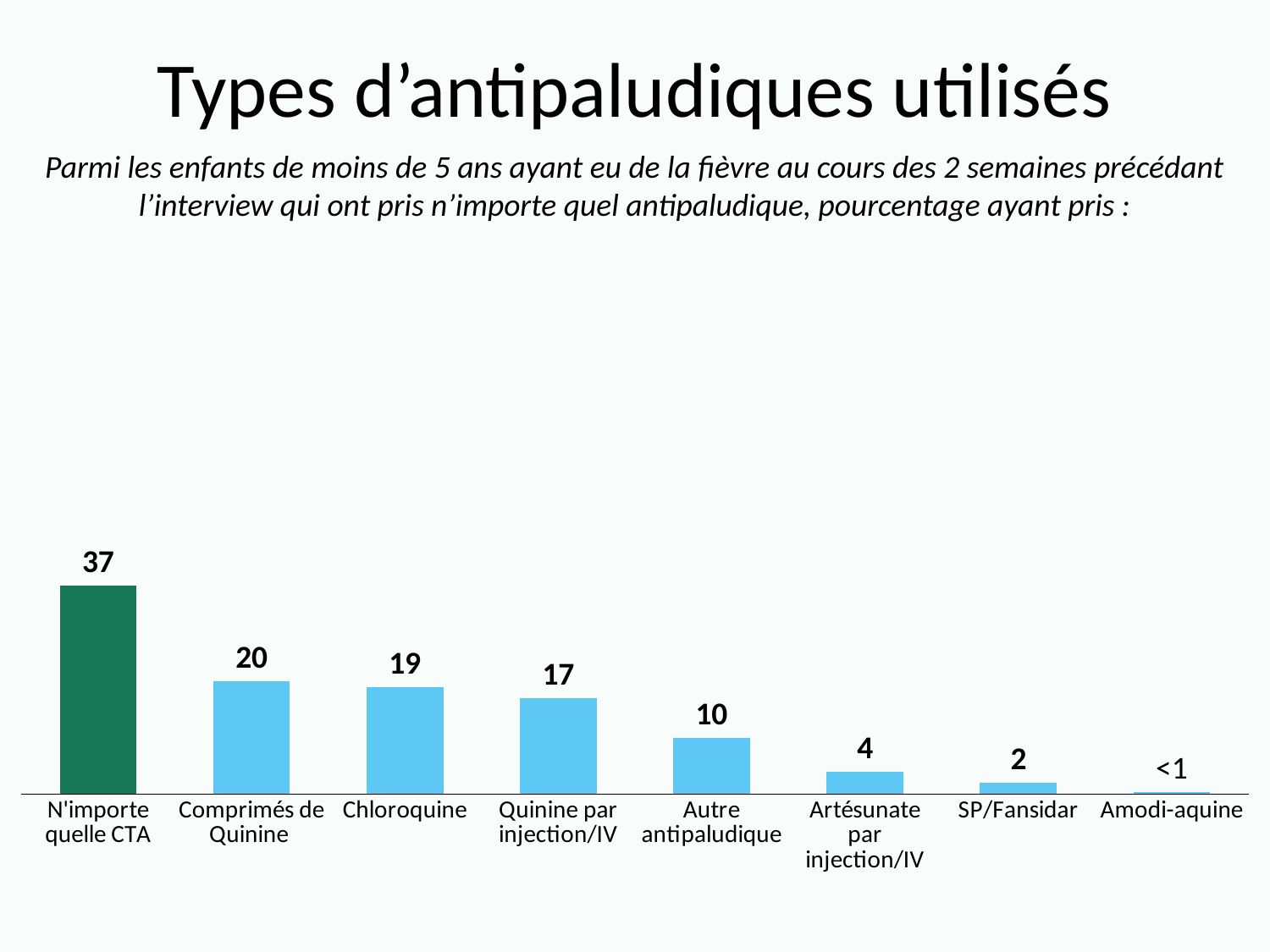
What is the difference between the values for N'importe quelle CTA and Comprimés de Quinine? 17 What is the value for Chloroquine? 19 What kind of chart is shown on the slide? Bar chart What is the value for Artésunate par injection/IV? 4 Which is larger, the value for Comprimés de Quinine or the value for Autre antipaludique? Comprimés de Quinine Which category has the lowest value? Amodi-aquine What is the difference between the values for Quinine par injection/IV and Autre antipaludique? 7 Which category has the highest value? N'importe quelle CTA What is the value shown for Amodi-aquine? <1 How many categories are shown in the chart? 8 What is the value for N'importe quelle CTA? 37 Which bar is shown in a different colour (dark green) from the others? N'importe quelle CTA